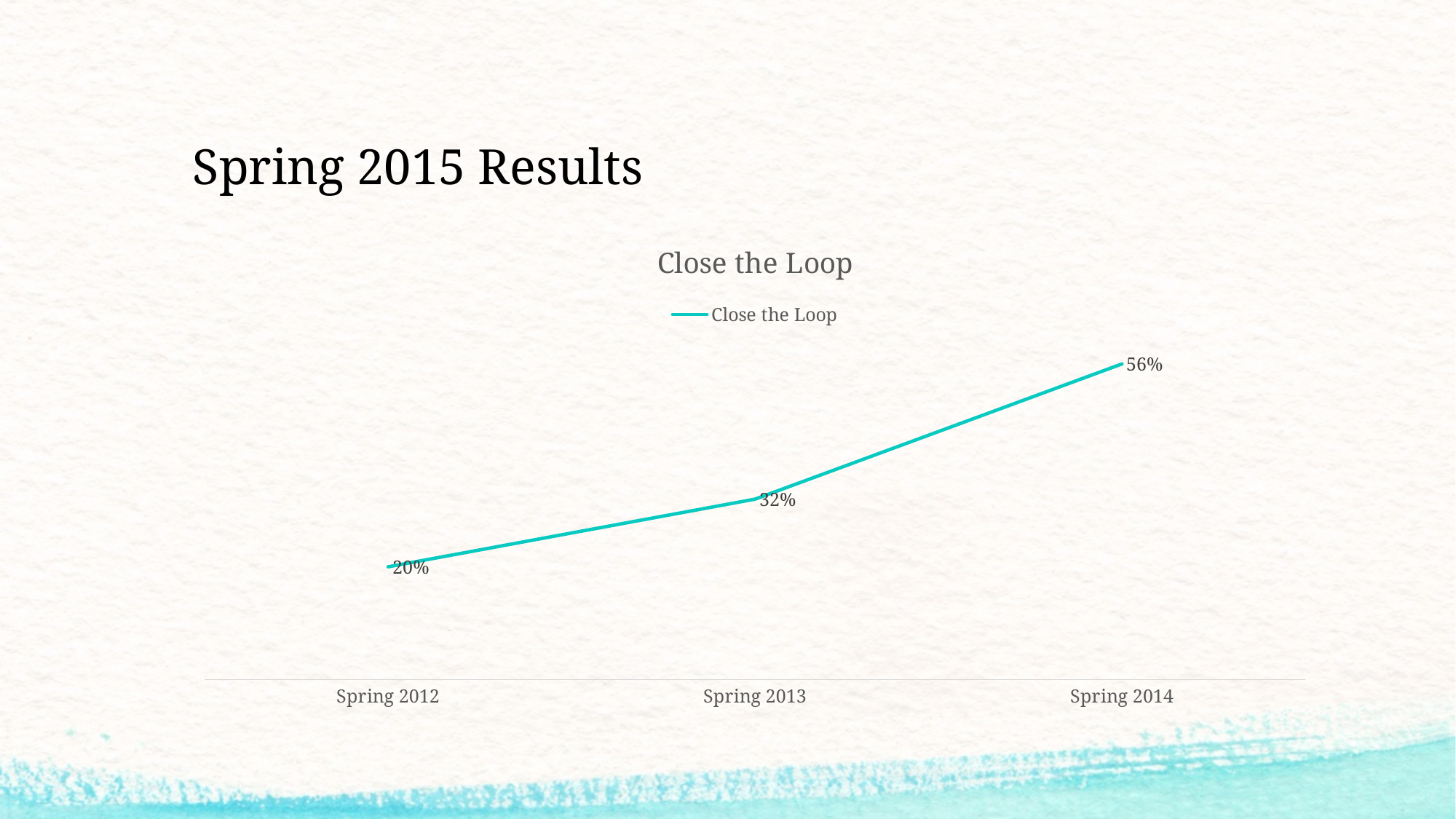
What kind of chart is shown on the slide? Line chart What is the value for Spring 2014? 56% What is the value for Spring 2013? 32% Which category has the lowest value? Spring 2012 Which category has the highest value? Spring 2014 What is the difference between the values for Spring 2013 and Spring 2012? 12% How many series does the legend list? 1 Do the values rise or fall from Spring 2012 to Spring 2014? Rise What is the difference between the values for Spring 2014 and Spring 2013? 24% How many data points are plotted on the chart? 3 What is the value for Spring 2012? 20% Which is larger, the value for Spring 2013 or Spring 2014? Spring 2014